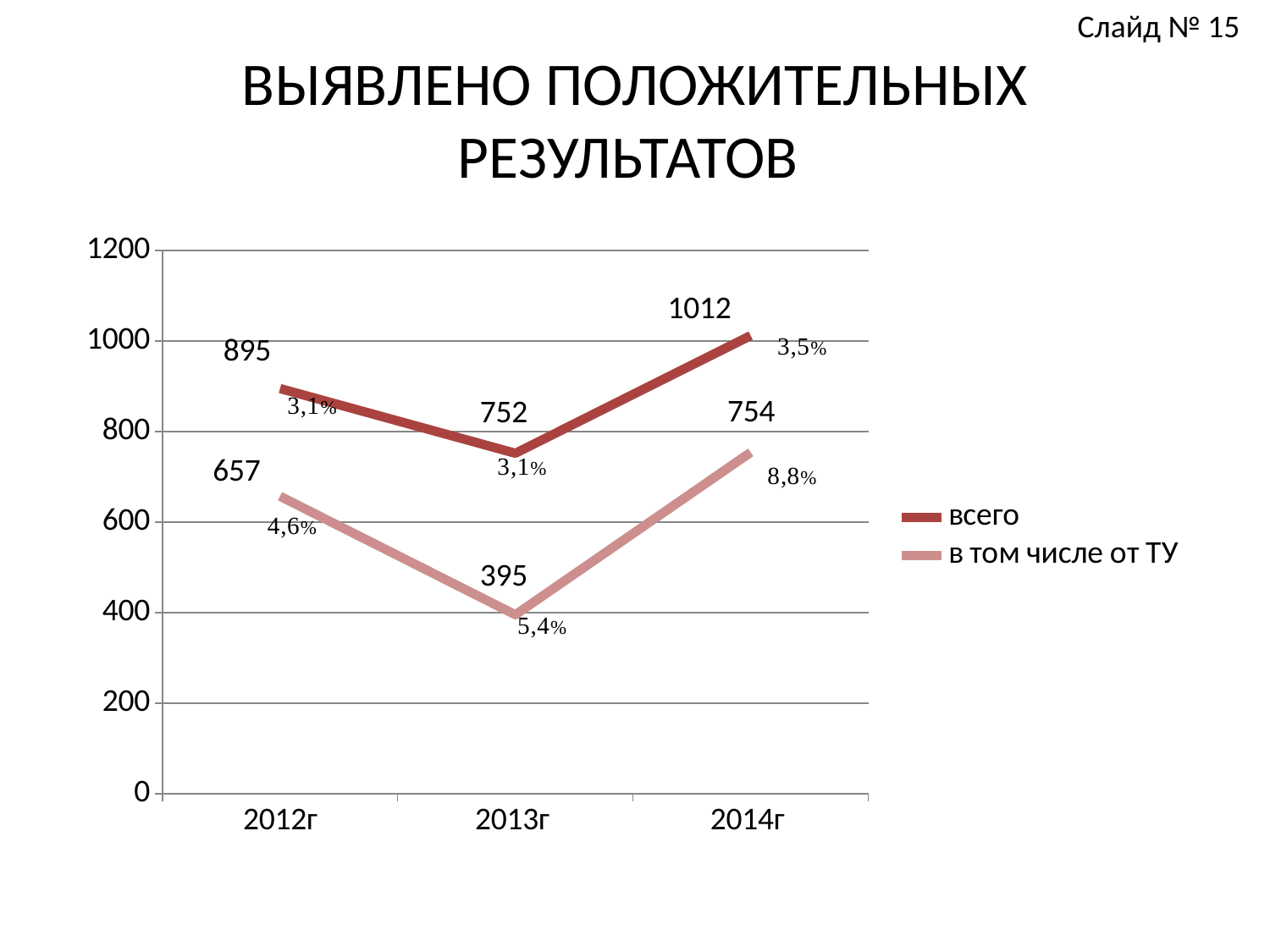
In which year is the "всего" series highest? 2014г Is the value for "всего" in 2014г greater or less than 1000? greater What is the difference between "всего" and "в том числе от ТУ" in 2014г? 258 What is the value for "всего" in 2012г? 895 What is the value for "в том числе от ТУ" in 2014г? 754 What is the value for "всего" in 2013г? 752 What kind of chart is shown on the slide? line chart How many years are shown on the x axis? 3 What is the difference between the "всего" values for 2012г and 2013г? 143 In which year is the "в том числе от ТУ" series lowest? 2013г How many series does the legend list? 2 Which is larger: "в том числе от ТУ" in 2012г or "в том числе от ТУ" in 2013г? 2012г